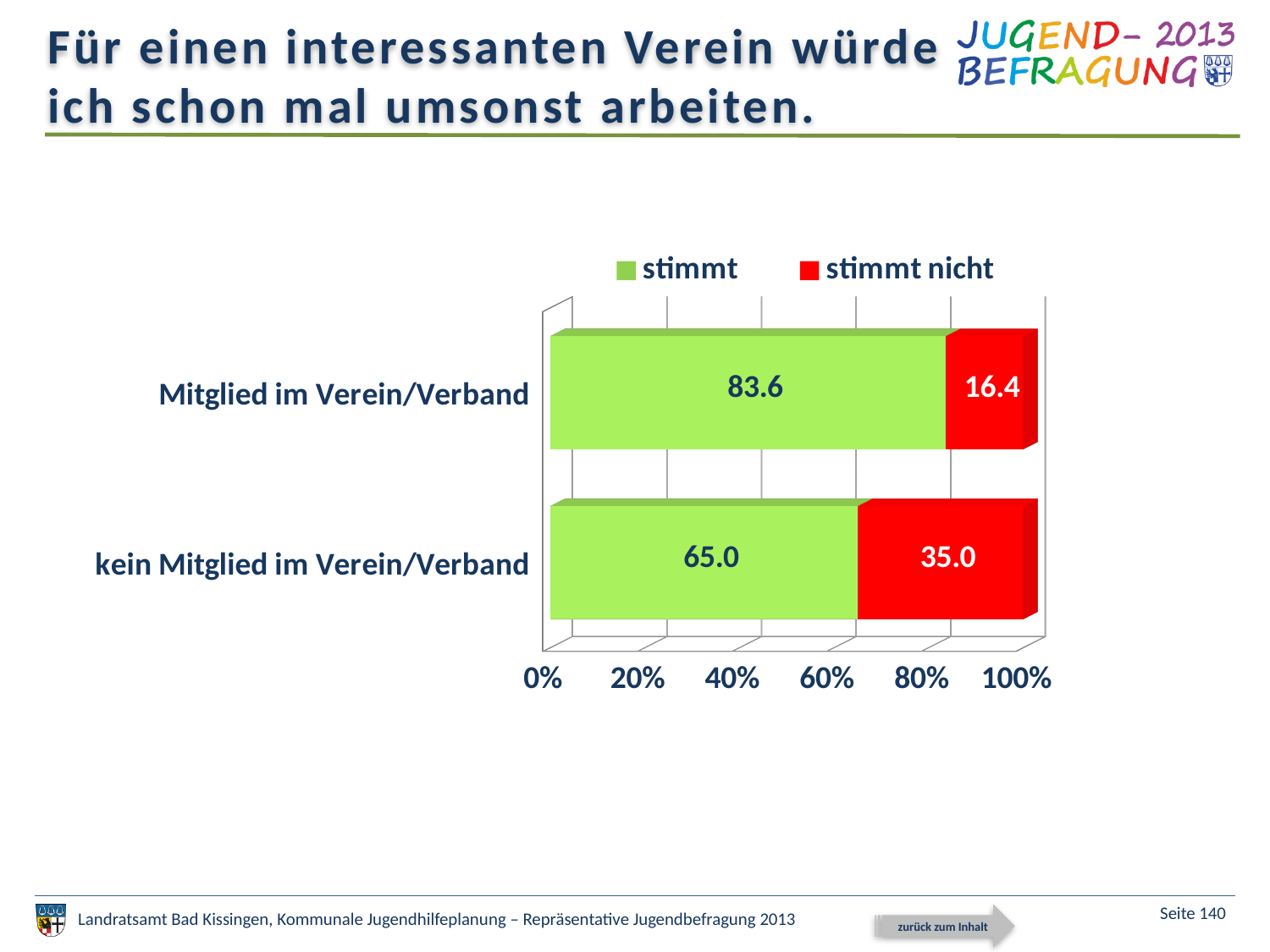
Which category has the higher "stimmt" value? Mitglied im Verein/Verband Which category has the lower "stimmt nicht" value? Mitglied im Verein/Verband How many categories are shown on the chart? 2 What is the value for "stimmt nicht" for "Mitglied im Verein/Verband"? 16.4 What is the value for "stimmt" for "Mitglied im Verein/Verband"? 83.6 What colour represents the "stimmt nicht" series? red What is the difference between the "stimmt" values for "Mitglied im Verein/Verband" and "kein Mitglied im Verein/Verband"? 18.6 Is the "stimmt nicht" value larger for "Mitglied im Verein/Verband" or for "kein Mitglied im Verein/Verband"? kein Mitglied im Verein/Verband What is the value for "stimmt" for "kein Mitglied im Verein/Verband"? 65.0 What is the value for "stimmt nicht" for "kein Mitglied im Verein/Verband"? 35.0 How many series does the legend list? 2 What kind of chart is shown on the slide? stacked bar chart